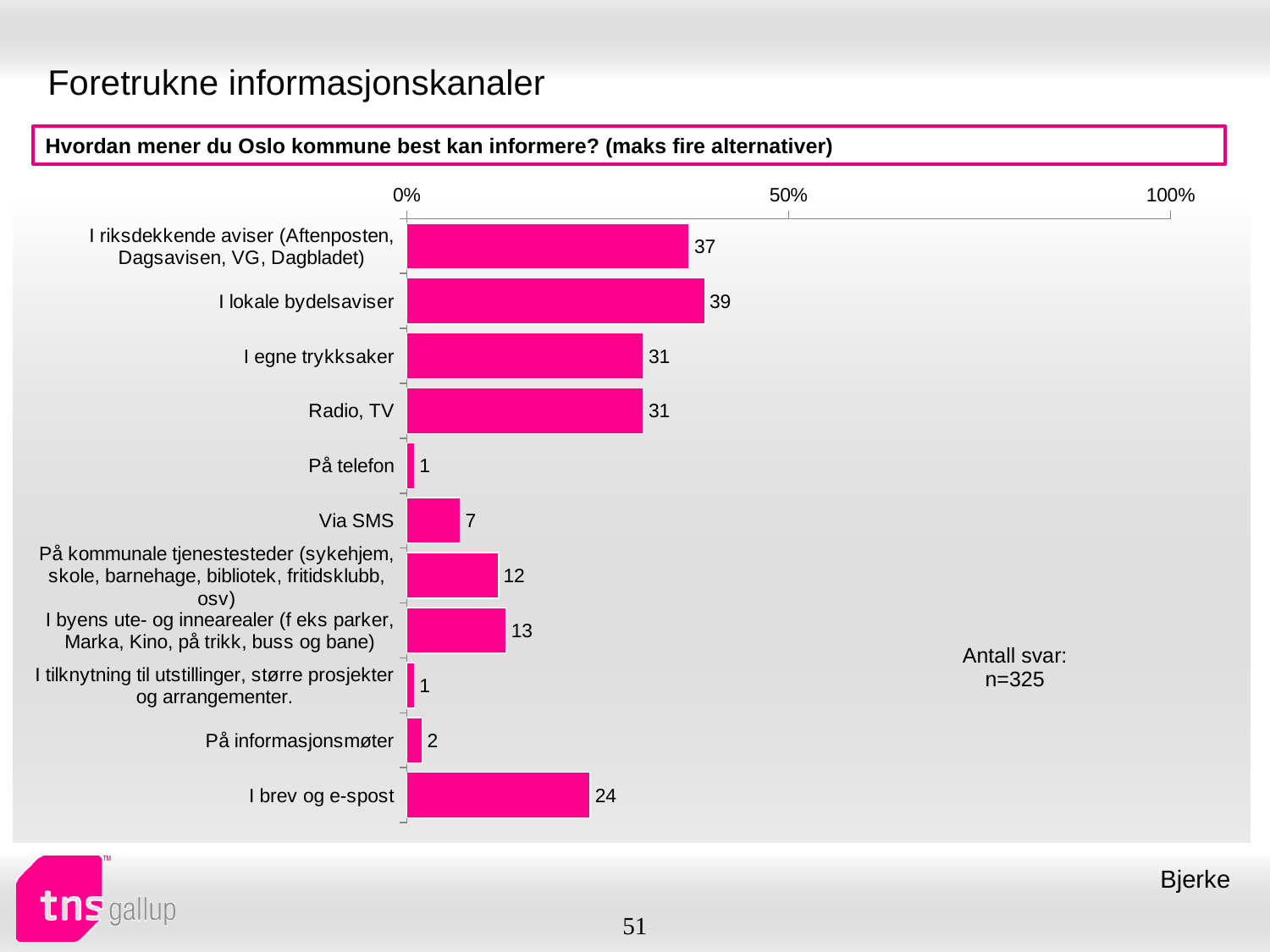
How many categories are shown in the chart? 11 What is the value for "I lokale bydelsaviser"? 39 What is the value for "Via SMS"? 7 What is the value for "På informasjonsmøter"? 2 What kind of chart is shown on the slide? bar chart What is the number of responses (n) stated on the slide? n=325 What is the difference between the values for "I byens ute- og innearealer (f eks parker, Marka, Kino, på trikk, buss og bane)" and "Via SMS"? 6 Is the value for "I riksdekkende aviser (Aftenposten, Dagsavisen, VG, Dagbladet)" greater or less than 50%? less Which category has the highest value? I lokale bydelsaviser What is the difference between the values for "I lokale bydelsaviser" and "I riksdekkende aviser (Aftenposten, Dagsavisen, VG, Dagbladet)"? 2 Which is larger, the value for "Radio, TV" or the value for "I brev og e-spost"? Radio, TV What is the value for "I brev og e-spost"? 24